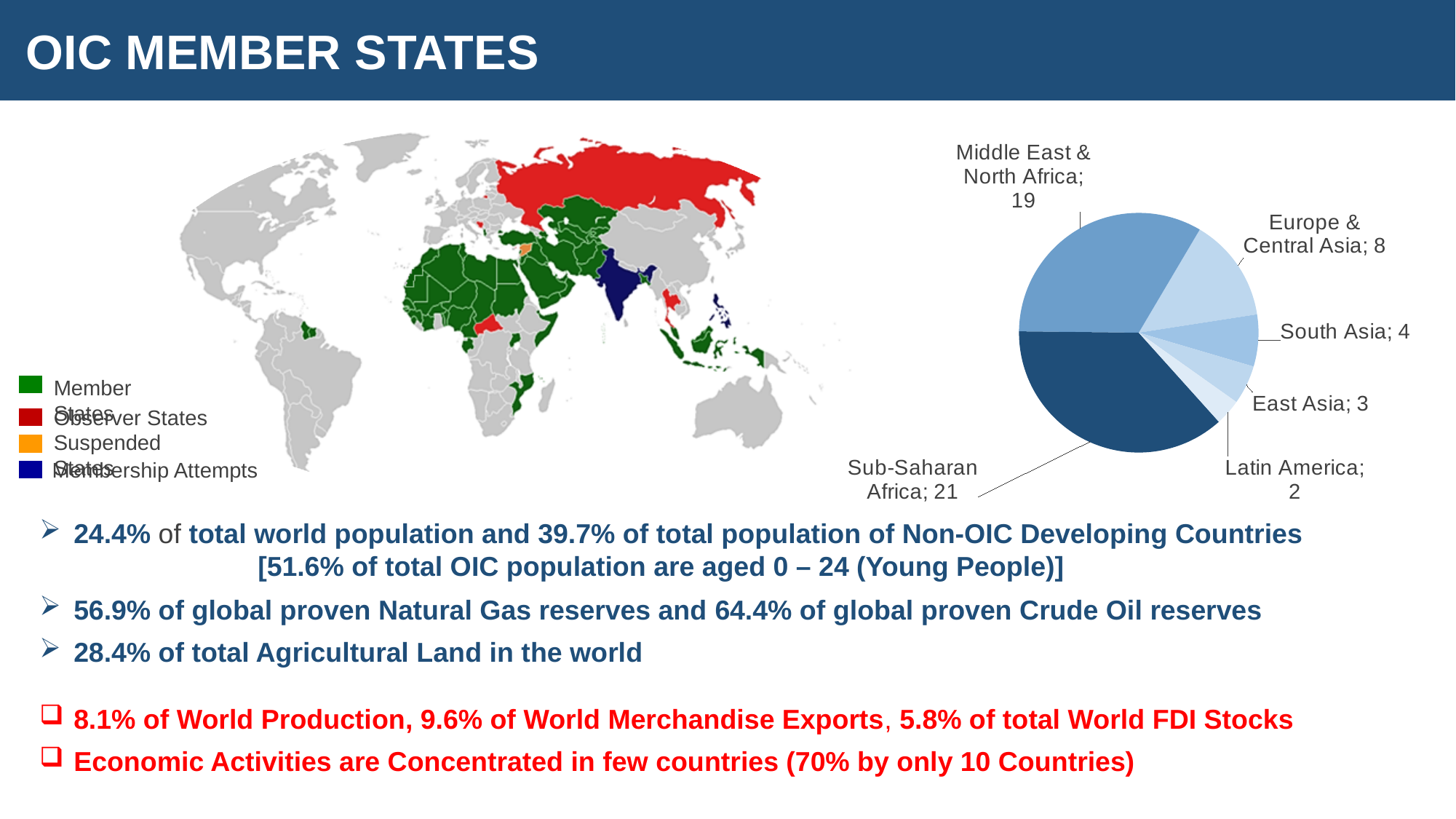
In the pie chart, how many member states are in Sub-Saharan Africa? 21 In the pie chart, what is the difference between the values for Europe & Central Asia and South Asia? 4 What is the total of all the values shown in the pie chart? 57 In the pie chart, what is the value for Latin America? 2 In the pie chart, what is the difference between the values for Sub-Saharan Africa and Middle East & North Africa? 2 What kind of chart is shown on the right side of the slide? Pie chart Which region has the largest slice in the pie chart? Sub-Saharan Africa In the pie chart, what is the value for Middle East & North Africa? 19 How many regions (slices) does the pie chart show? 6 In the pie chart, which is larger: South Asia or East Asia? South Asia In the pie chart, what is the value for Europe & Central Asia? 8 Which region has the smallest slice in the pie chart? Latin America